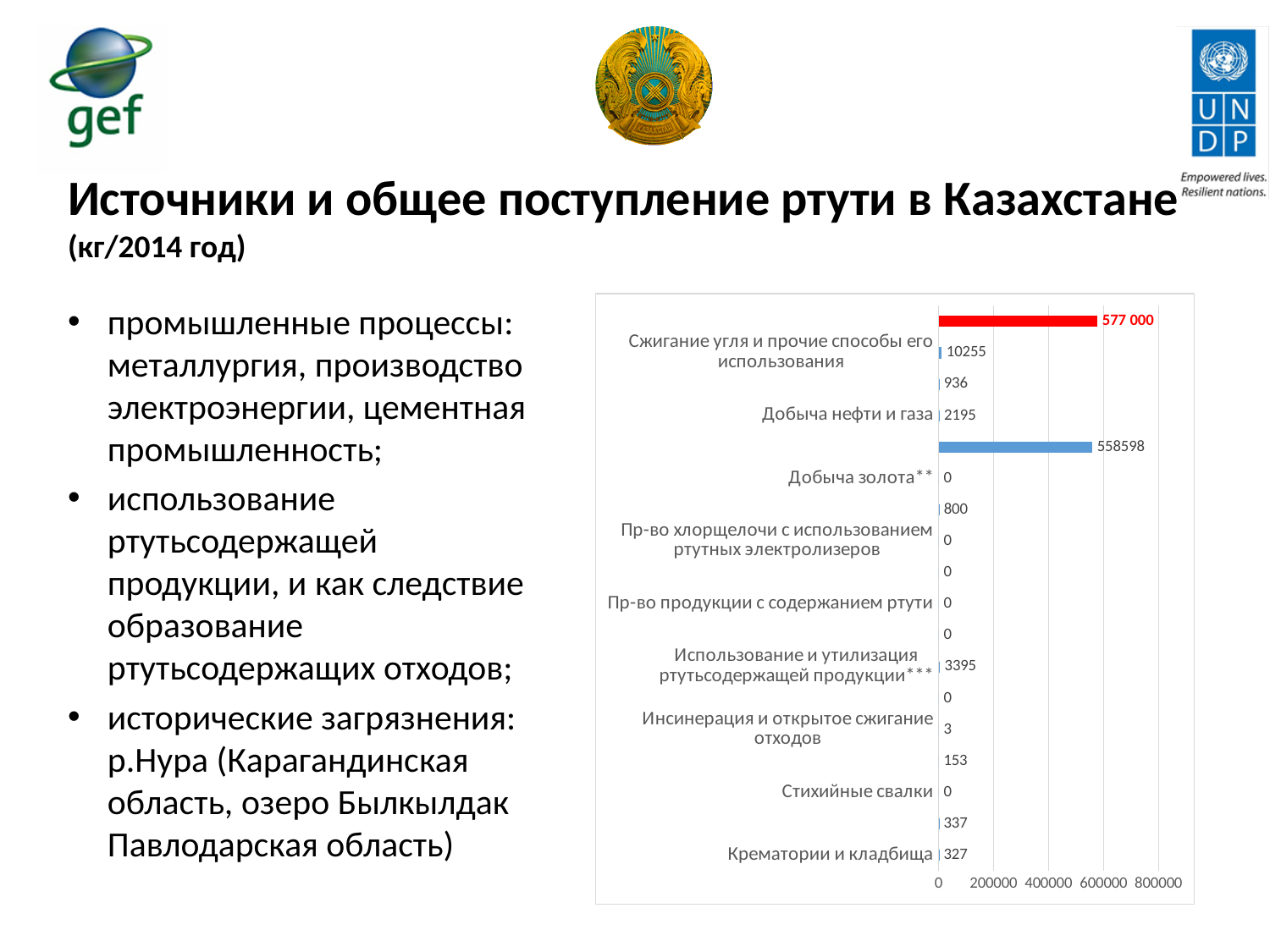
What is the value for Стихийные свалки? 0 What is the value for Сжигание угля и прочие способы его использования? 10255 What is the value for Добыча нефти и газа? 2195 What is the largest value shown on the chart? 577 000 What is the value for Крематории и кладбища? 327 What kind of chart is shown on the slide? Bar chart What is the value for Использование и утилизация ртутьсодержащей продукции***? 3395 Which is larger, the value for Сжигание угля и прочие способы его использования or the value for Добыча нефти и газа? Сжигание угля и прочие способы его использования What is the value for Добыча золота**? 0 What is the value for Инсинерация и открытое сжигание отходов? 3 What is the highest value shown on the horizontal axis of the chart? 800000 What is the difference between the value for Сжигание угля и прочие способы его использования and the value for Добыча нефти и газа? 8060